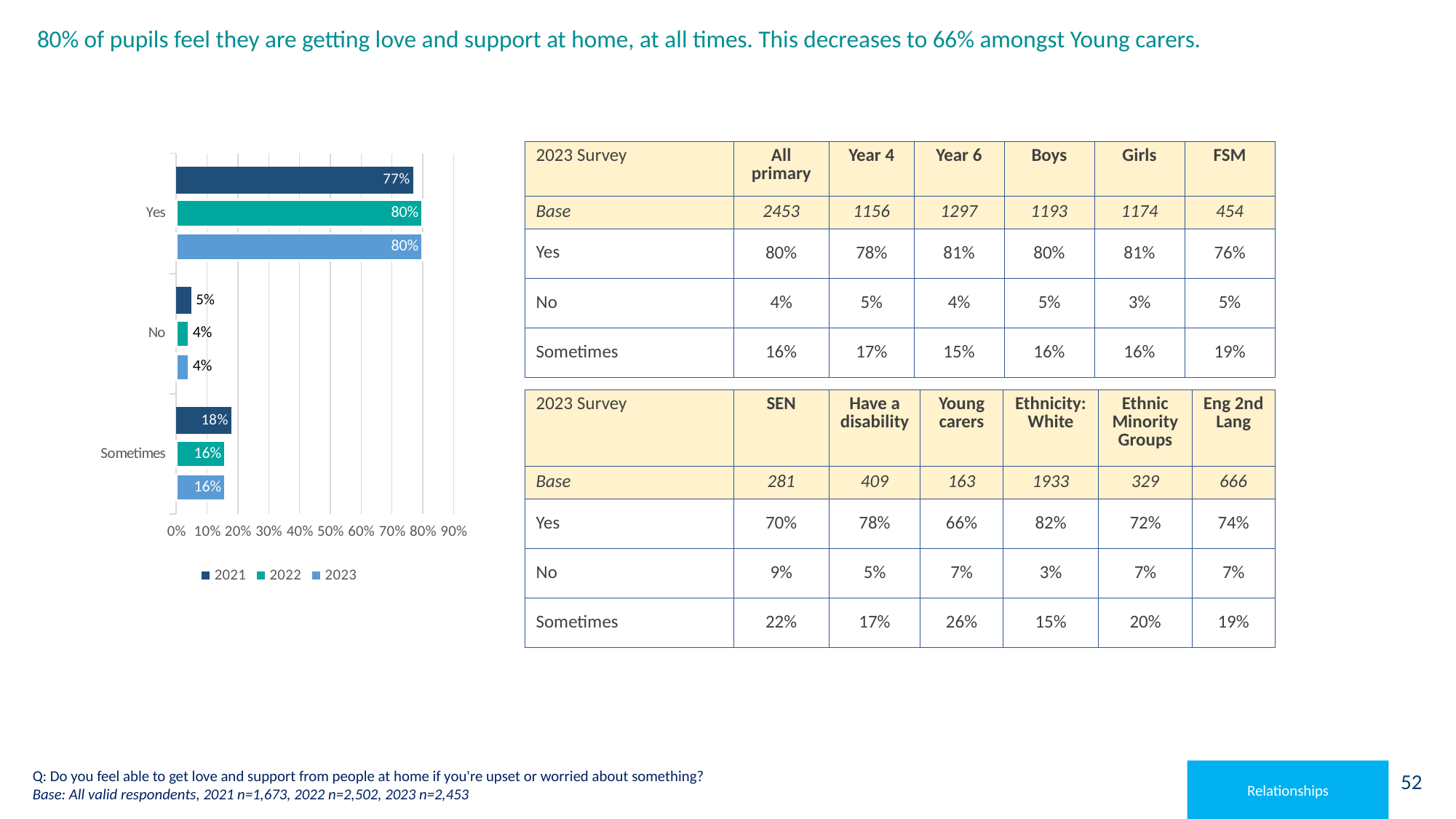
What kind of chart is shown on the slide? bar chart Which category has the highest value in the 2023 series? Yes How many series does the chart legend list? 3 What is the value for 'No' in the 2021 series? 5% How many categories are shown on the chart's vertical axis? 3 Which category has the lowest value in the 2021 series? No What is the value for 'Yes' in the 2021 series? 77% Which series in the legend is shown in dark blue? 2021 What is the difference between the 2021 and 2022 values for 'Sometimes'? 2% Which is larger: the 2021 value for 'Yes' or the 2022 value for 'Yes'? 2022 What is the value for 'Yes' in the 2023 series? 80% What is the value for 'Sometimes' in the 2022 series? 16%